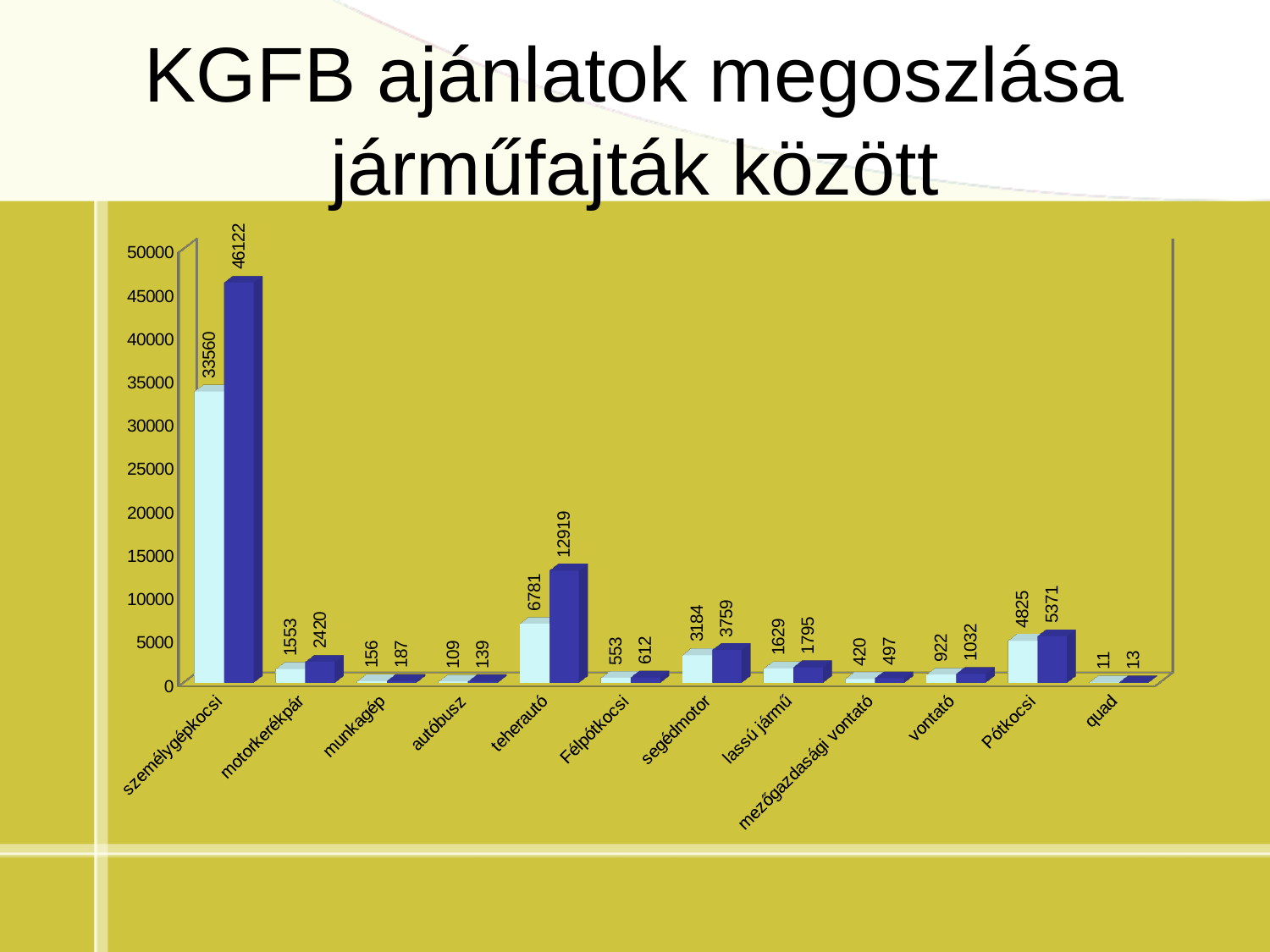
What is the value of the dark blue bar for személygépkocsi? 46122 What is the difference between the dark blue and light blue bars for teherautó? 6138 Which is larger, the dark blue bar for segédmotor or the dark blue bar for Pótkocsi? Pótkocsi What is the value of the dark blue bar for Pótkocsi? 5371 What is the value of the light blue bar for quad? 11 Which category has the highest dark blue bar? személygépkocsi Which category has the lowest light blue bar? quad What is the value of the light blue bar for teherautó? 6781 How many vehicle categories are shown on the x axis? 12 What is the difference between the dark blue and light blue bars for személygépkocsi? 12562 What is the title of the slide? KGFB ajánlatok megoszlása járműfajták között What kind of chart is shown on the slide? bar chart